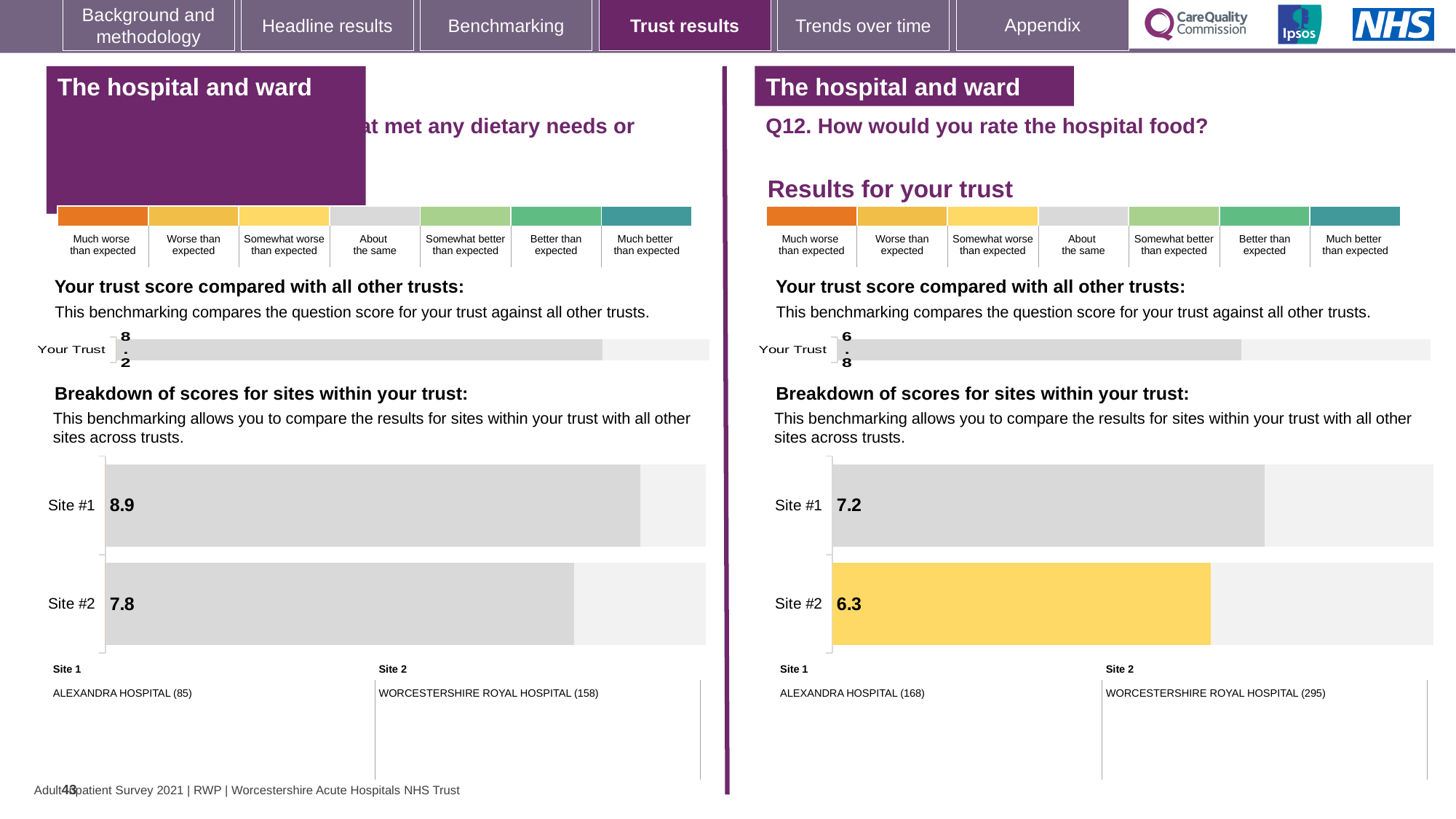
On the left-hand 'Your trust score compared with all other trusts' bar, what is the trust score? 8.2 On the right-hand 'Your trust score compared with all other trusts' bar (Q12, hospital food), what is the trust score? 6.8 On the left-hand site breakdown chart, what is the score for Site #1? 8.9 On the right-hand chart (Q12, hospital food), what is the score for Site #2? 6.3 On the right-hand chart (Q12, hospital food), which site has the higher score? Site #1 On the left-hand site breakdown chart, which site has the lower score? Site #2 On the left-hand site breakdown chart, what is the score for Site #2? 7.8 On the left-hand site breakdown chart, what is the difference between the Site #1 and Site #2 scores? 1.1 On the right-hand chart (Q12, hospital food), what is the difference between the Site #1 and Site #2 scores? 0.9 What type of chart is used for the site breakdown on the right-hand side (Q12, hospital food)? Bar chart How many sites are shown in the right-hand site breakdown chart (Q12, hospital food)? 2 On the right-hand chart (Q12, hospital food), what is the score for Site #1? 7.2